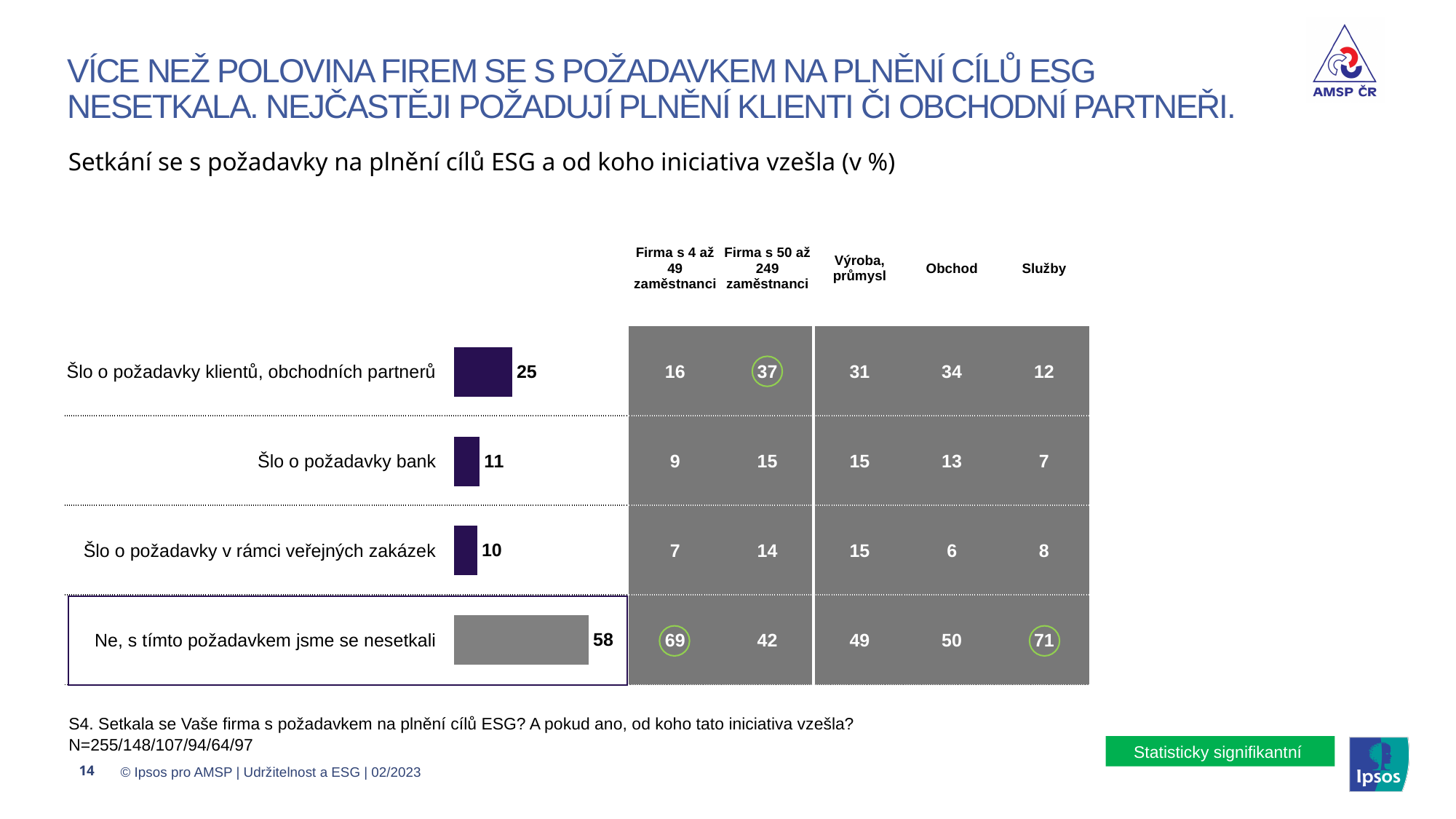
What value is shown for "Ne, s tímto požadavkem jsme se nesetkali" in the bar chart? 58 What is the difference between the values for "Ne, s tímto požadavkem jsme se nesetkali" and "Šlo o požadavky klientů, obchodních partnerů"? 33 How many categories are shown in the bar chart? 4 Which category has the highest value in the bar chart? Ne, s tímto požadavkem jsme se nesetkali Which category has the lowest value in the bar chart? Šlo o požadavky v rámci veřejných zakázek Which is larger: the value for "Šlo o požadavky bank" or for "Šlo o požadavky v rámci veřejných zakázek"? Šlo o požadavky bank What value is shown for "Šlo o požadavky bank" in the bar chart? 11 What is the subtitle of the chart on the slide? Setkání se s požadavky na plnění cílů ESG a od koho iniciativa vzešla (v %) What kind of chart is shown on the slide? Bar chart What value is shown for "Šlo o požadavky klientů, obchodních partnerů" in the bar chart? 25 In the table, what is the value for "Ne, s tímto požadavkem jsme se nesetkali" in the "Služby" column? 71 In the table, what is the value for "Šlo o požadavky klientů, obchodních partnerů" in the "Firma s 50 až 249 zaměstnanci" column? 37